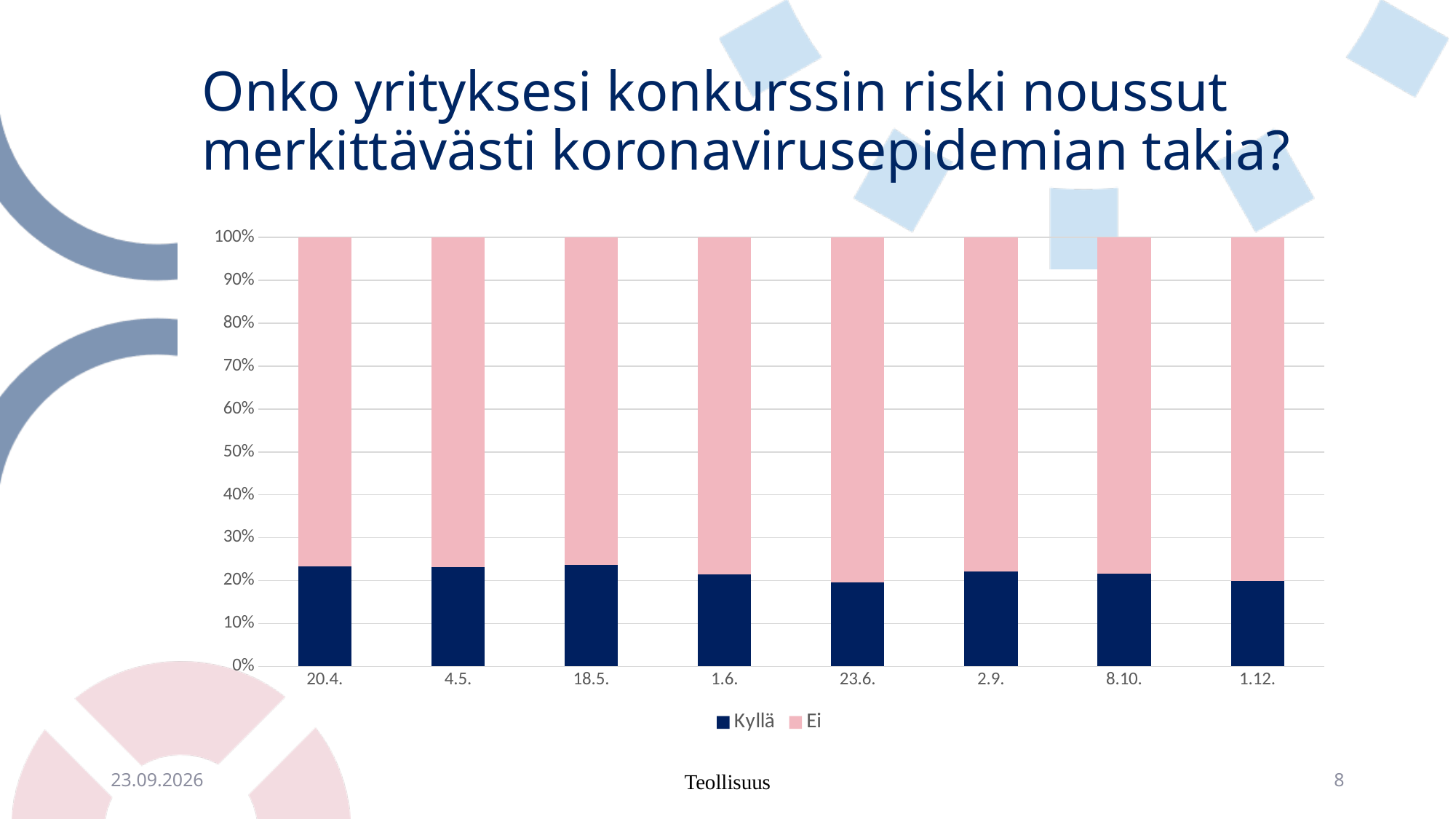
Which has the larger 'Kyllä' share: 18.5. or 23.6.? 18.5. Which colour represents the 'Kyllä' series in the chart? Dark blue How many series does the chart legend list? 2 Is the 'Ei' share for 1.12. greater or less than 70%? greater What is the total height of the stacked bar for 20.4.? 100% How many dates (categories) are shown on the x axis of the chart? 8 Which has the larger 'Kyllä' share: 20.4. or 1.12.? 20.4. What are the two series named in the chart legend? Kyllä and Ei What kind of chart is shown on the slide? Stacked bar chart Is the 'Kyllä' value for 20.4. greater or less than 20%? greater Is the 'Kyllä' value for 23.6. greater or less than 30%? less